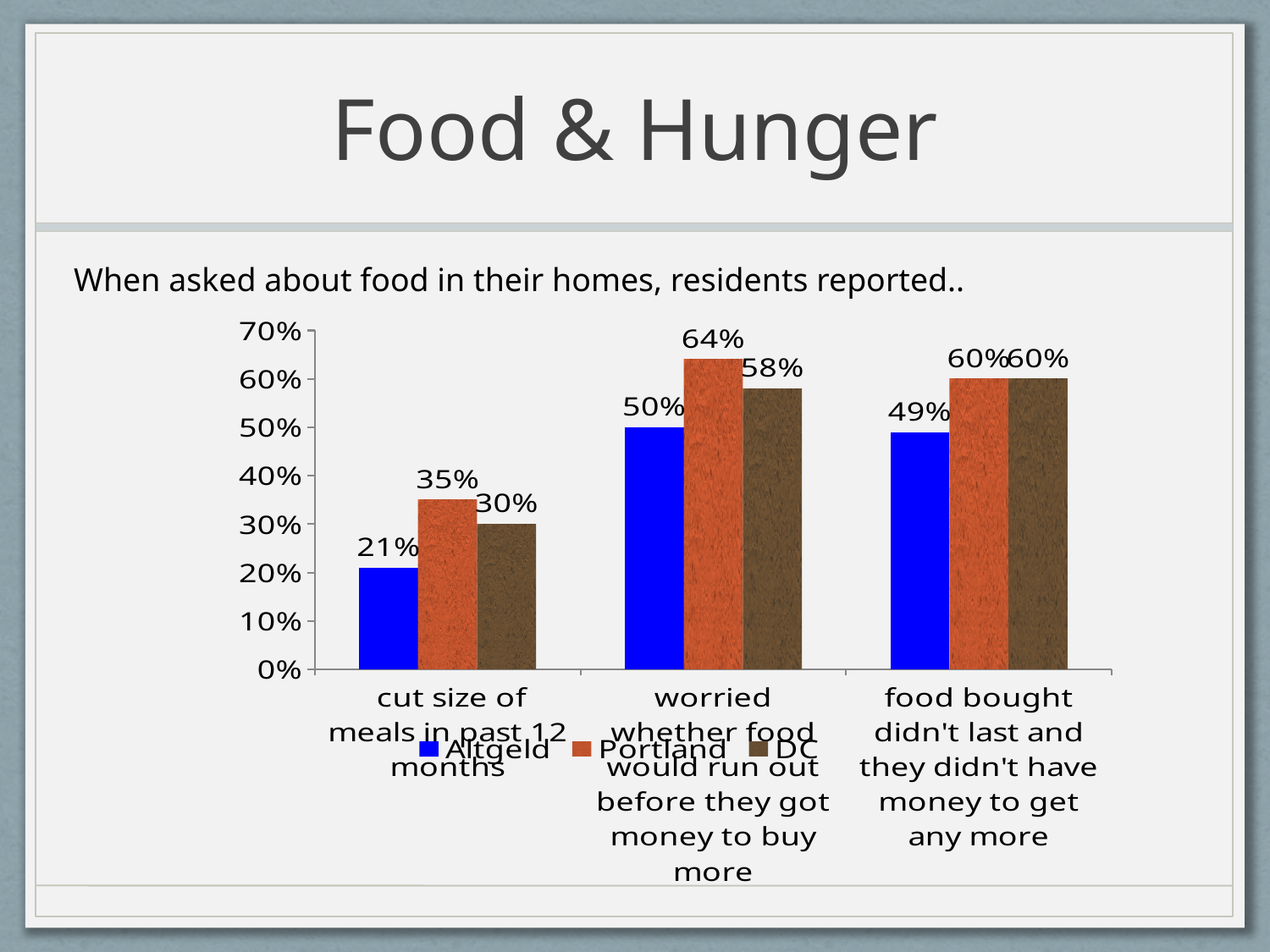
Which series has the highest value in the 'cut size of meals in past 12 months' category? Portland Which series has the lowest value in the 'worried whether food would run out' category? Altgeld What percentage of Altgeld residents reported cutting the size of meals in the past 12 months? 21% What colour are the bars for the Altgeld series? blue How many series does the legend list? 3 What kind of chart is shown on the slide? bar chart What is the difference between the Portland and Altgeld values for 'worried whether food would run out before they got money to buy more'? 14% How many categories are shown on the x axis of the chart? 3 Is the Altgeld value for 'food bought didn't last and they didn't have money to get any more' greater or less than 50%? less Which is larger: the DC value for 'cut size of meals in past 12 months' or the Altgeld value for the same category? DC What value is shown for Portland in the 'worried whether food would run out before they got money to buy more' category? 64% What value is shown for DC in the 'food bought didn't last and they didn't have money to get any more' category? 60%